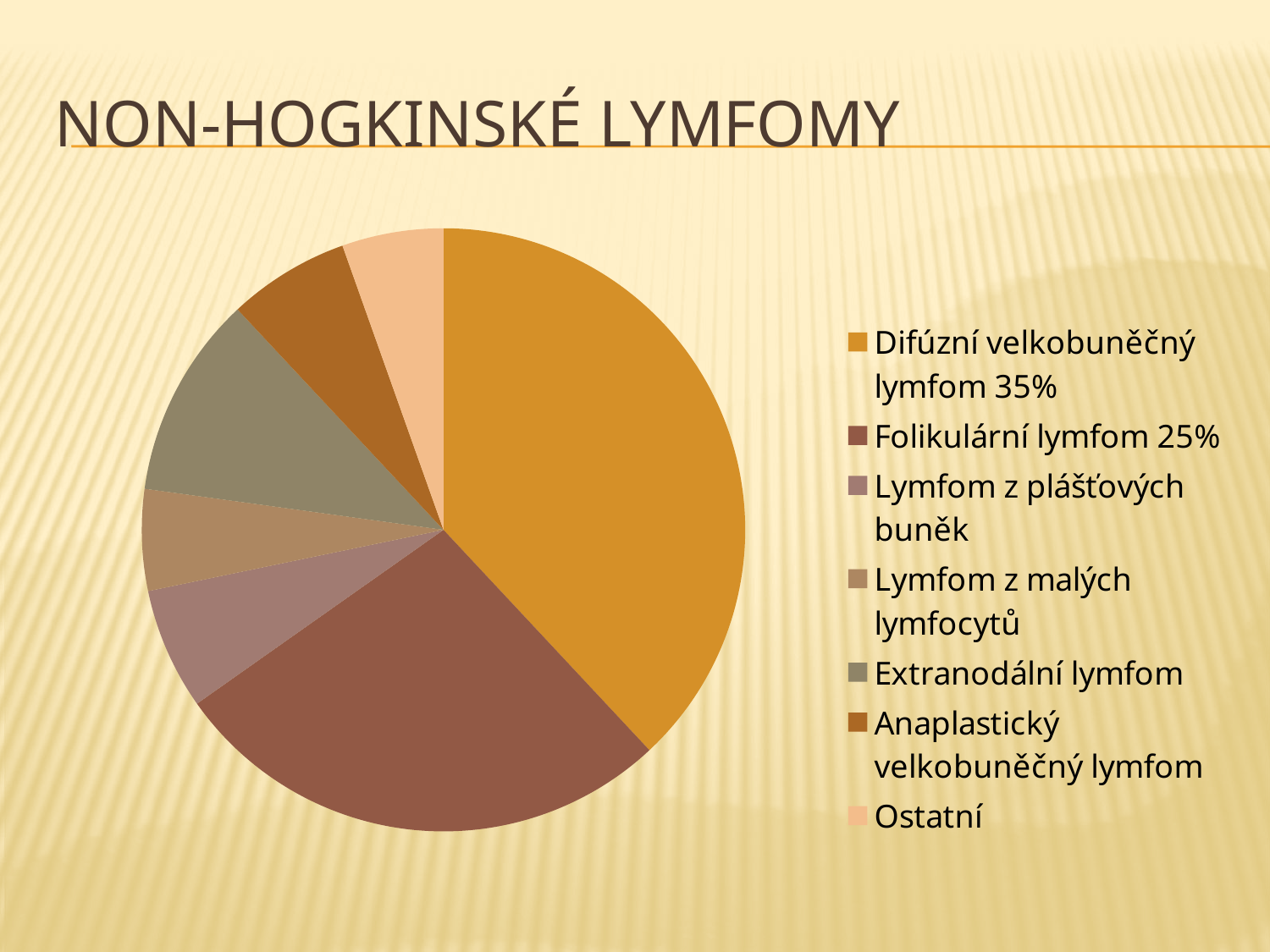
What is the title of the slide containing the pie chart? NON-HOGKINSKÉ LYMFOMY What is the difference between the shares of Difúzní velkobuněčný lymfom and Folikulární lymfom? 10% Which category has the largest slice of the pie? Difúzní velkobuněčný lymfom Which is larger, the slice for Folikulární lymfom or the slice for Extranodální lymfom? Folikulární lymfom What kind of chart is shown on the slide? pie chart Which is larger, the slice for Extranodální lymfom or the slice for Ostatní? Extranodální lymfom How many slices does the pie chart have? 7 Which legend entry is listed last in the pie chart's legend? Ostatní What share of the pie does Folikulární lymfom represent? 25% What is the combined share of Difúzní velkobuněčný lymfom and Folikulární lymfom? 60% Which is larger, the slice for Difúzní velkobuněčný lymfom or the slice for Folikulární lymfom? Difúzní velkobuněčný lymfom What share of the pie does Difúzní velkobuněčný lymfom represent? 35%